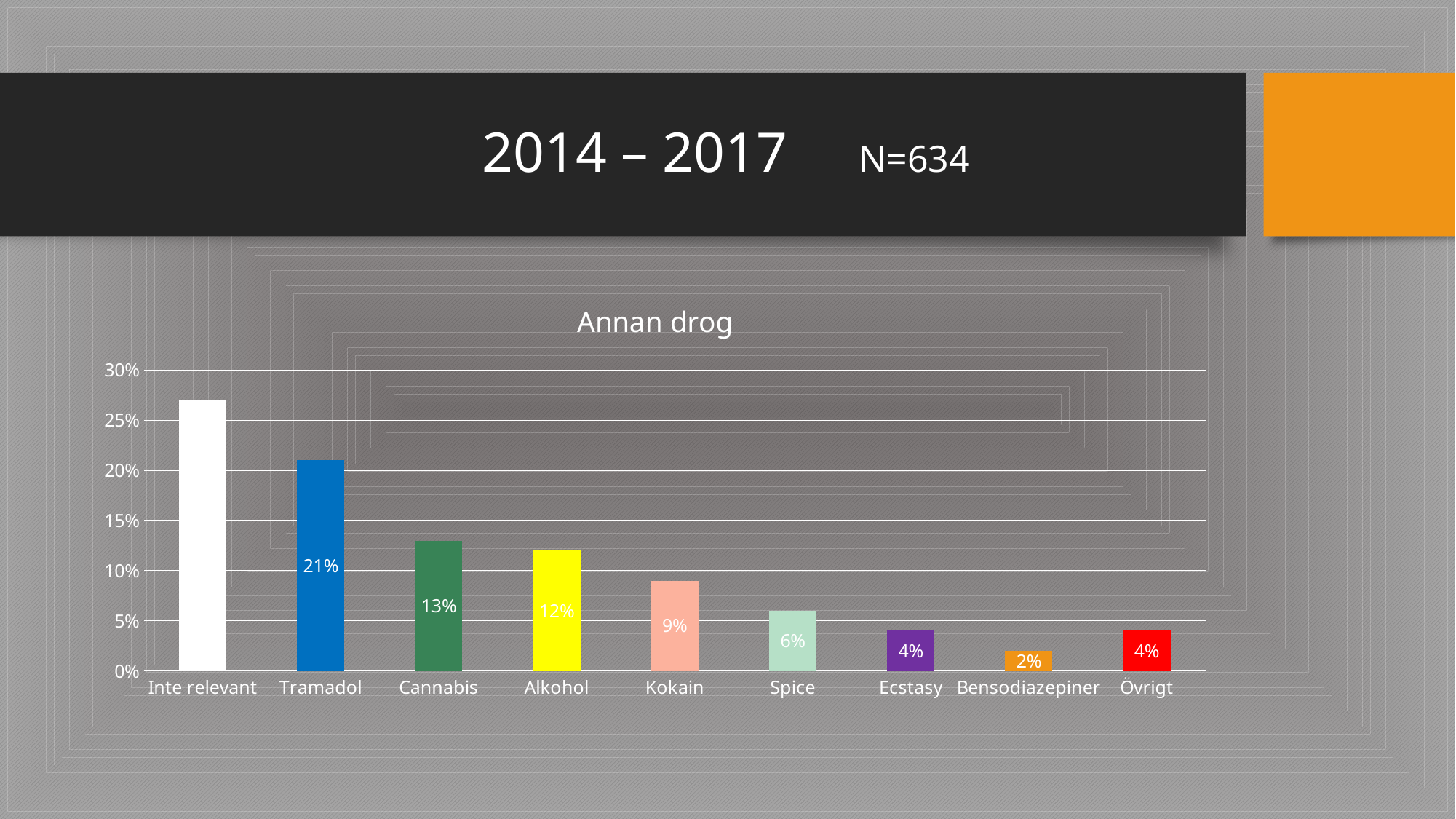
What kind of chart is shown on the slide? bar chart What is the difference between the values for Tramadol and Cannabis? 8% What is the value for Bensodiazepiner? 2% What is the value for Cannabis? 13% What is the value for Tramadol in the Annan drog chart? 21% Is the value for Inte relevant greater or less than 25%? greater Which category has the highest bar in the chart? Inte relevant Which category has the lowest value? Bensodiazepiner What is the title of the chart? Annan drog How many categories are shown on the x axis? 9 Which is larger, the value for Alkohol or the value for Spice? Alkohol What is the value for Kokain? 9%